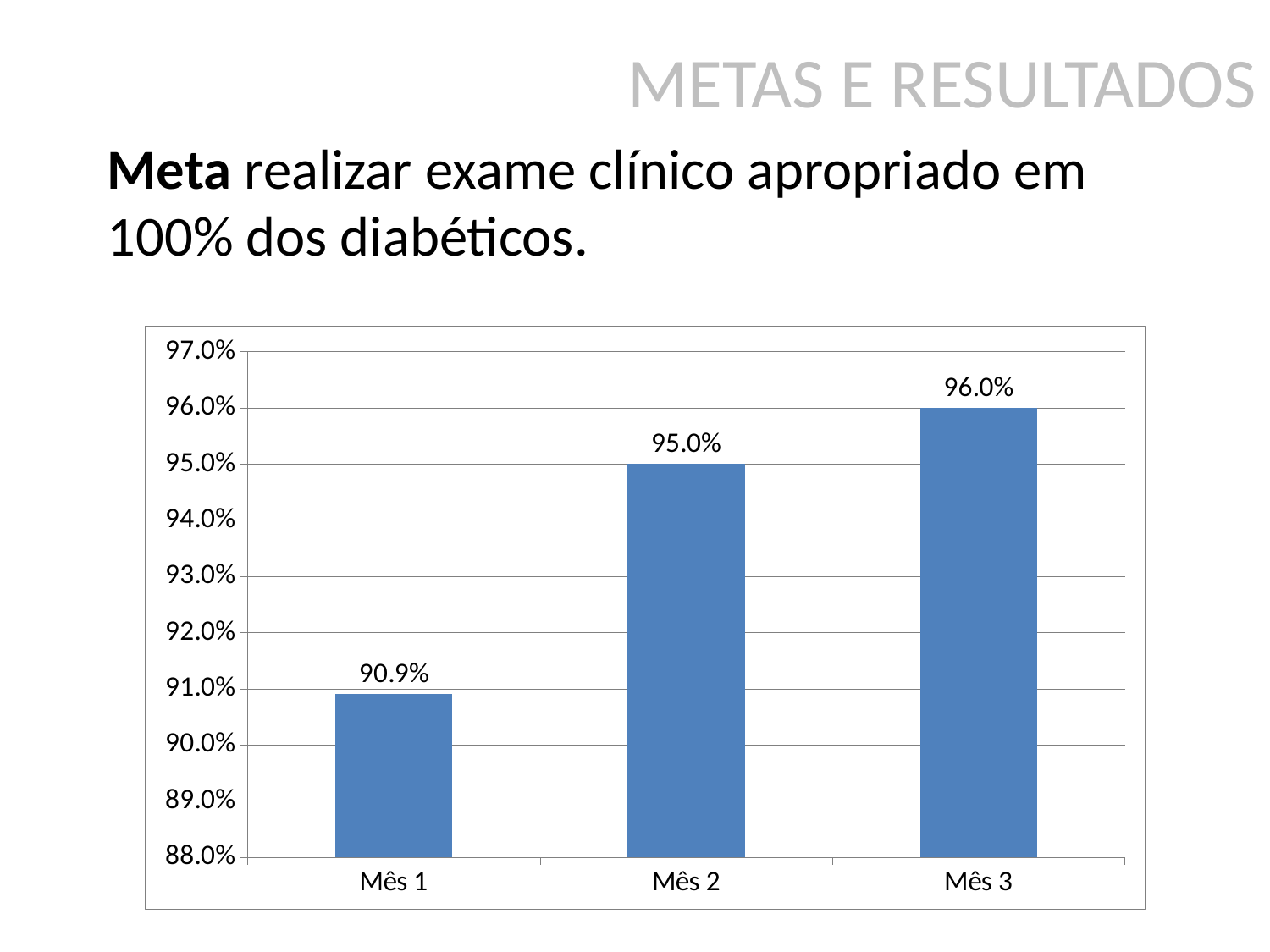
Which is larger, the value for Mês 2 or the value for Mês 3? Mês 3 Which month has the highest value? Mês 3 Which month has the lowest value? Mês 1 Do the values rise or fall from Mês 1 to Mês 3? rise What is the value for Mês 3? 96.0% What is the value for Mês 2? 95.0% What kind of chart is shown on the slide? bar chart What is the difference between the values for Mês 3 and Mês 1? 5.1% What is the value for Mês 1? 90.9% What is the difference between the values for Mês 2 and Mês 1? 4.1% How many categories are shown on the x axis? 3 Is the value for Mês 1 greater or less than 92.0%? less